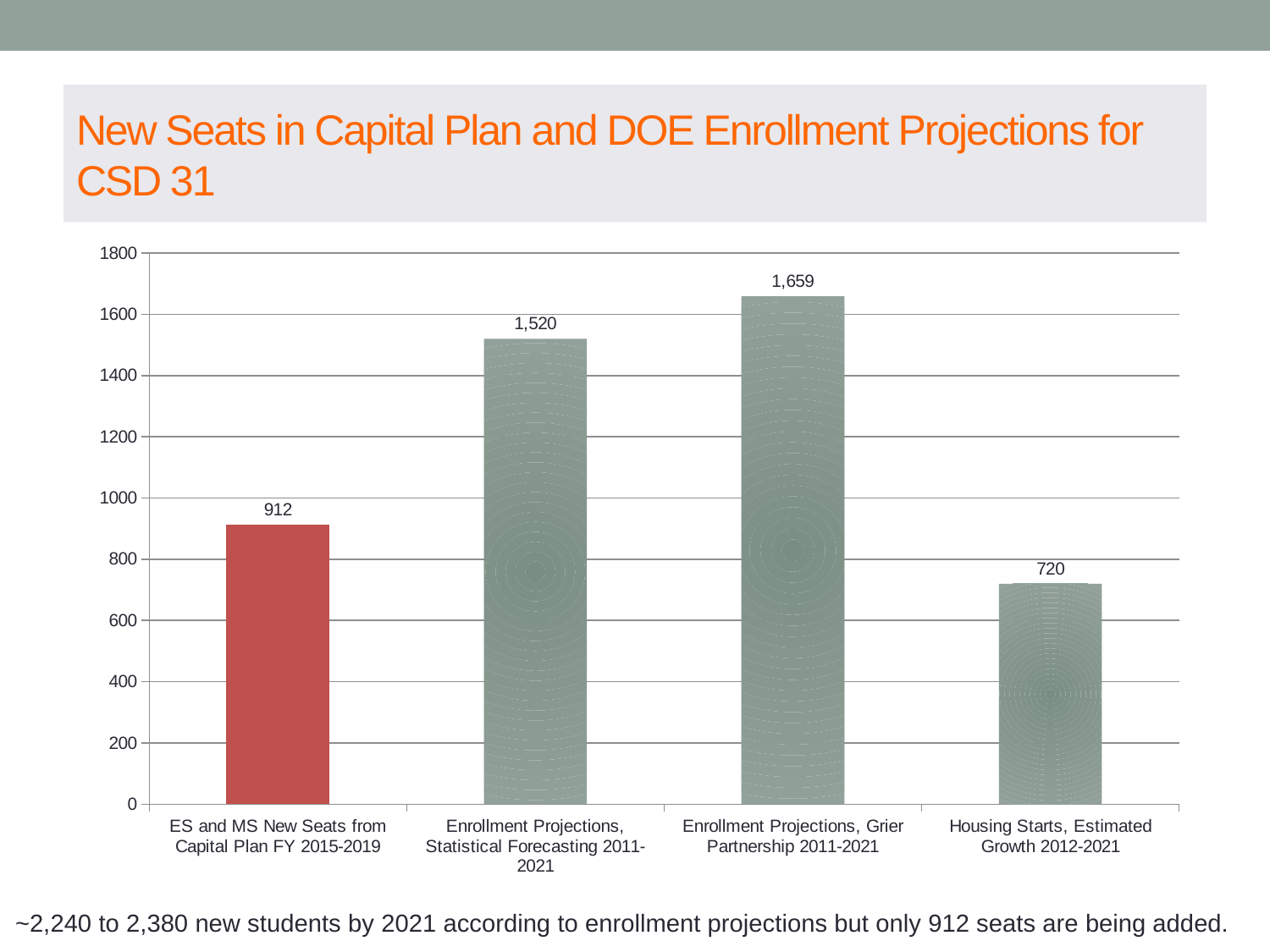
Which bar is shown in a different colour (red) from the others? ES and MS New Seats from Capital Plan FY 2015-2019 How many categories are shown in the chart? 4 Which is larger, the value for ES and MS New Seats from Capital Plan FY 2015-2019 or the value for Housing Starts, Estimated Growth 2012-2021? ES and MS New Seats from Capital Plan FY 2015-2019 Which category has the lowest value? Housing Starts, Estimated Growth 2012-2021 What is the value for Housing Starts, Estimated Growth 2012-2021? 720 What is the difference between the Statistical Forecasting enrollment projection and the ES and MS New Seats from Capital Plan FY 2015-2019? 608 What is the value for ES and MS New Seats from Capital Plan FY 2015-2019? 912 What is the difference between the Grier Partnership enrollment projection and the Statistical Forecasting enrollment projection? 139 What is the value for Enrollment Projections, Statistical Forecasting 2011-2021? 1,520 What kind of chart is shown on the slide? Bar chart Which category has the highest value? Enrollment Projections, Grier Partnership 2011-2021 What is the value for Enrollment Projections, Grier Partnership 2011-2021? 1,659